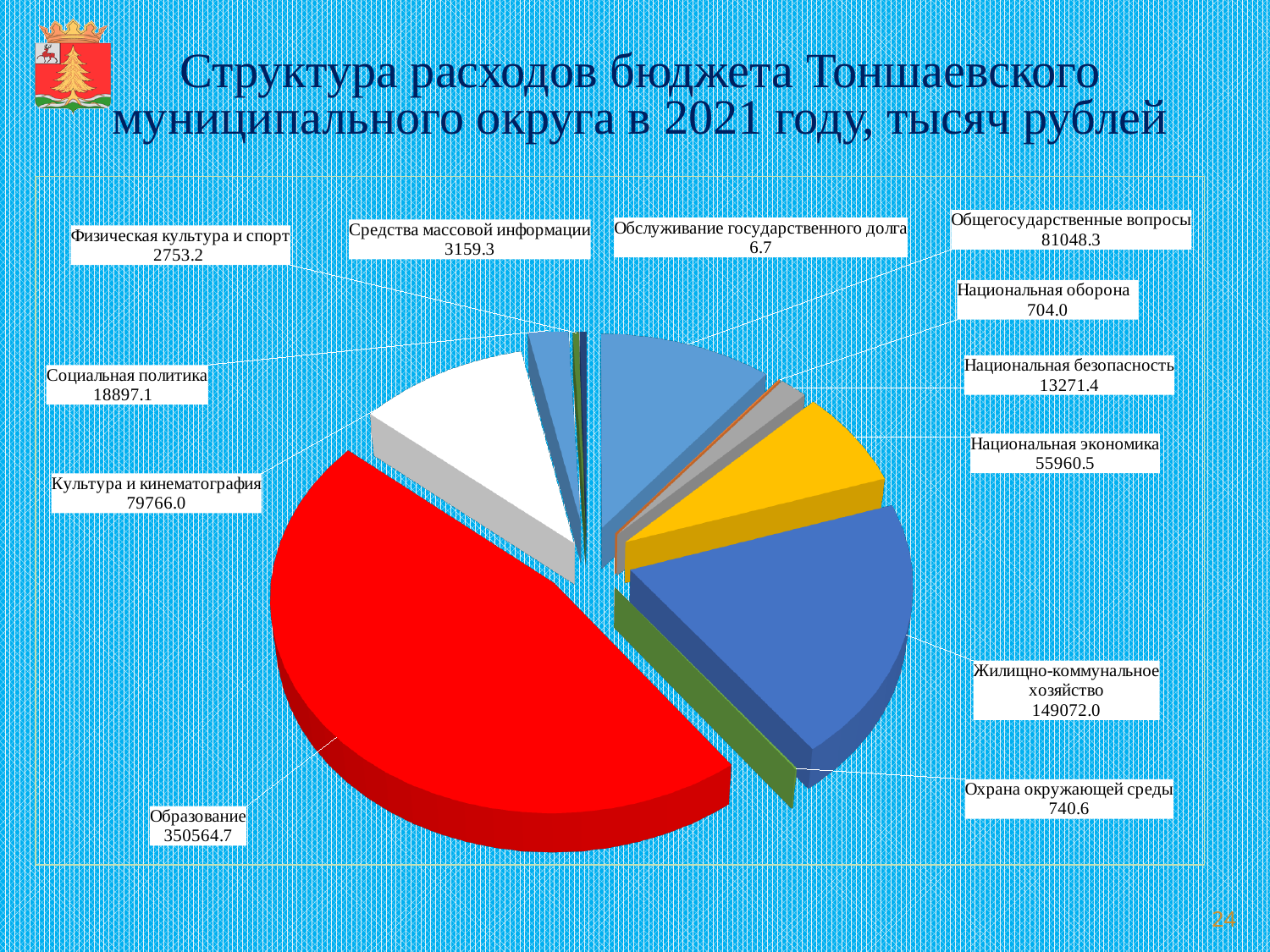
What is the value for Образование? 350564.7 In what units are the values in the chart expressed, according to the title? тысяч рублей What is the value for Социальная политика? 18897.1 Which category has the largest value in the pie chart? Образование How many categories (slices) does the pie chart show? 12 What is the value for Национальная оборона? 704.0 What is the difference between Жилищно-коммунальное хозяйство and Общегосударственные вопросы? 68023.7 What is the difference between Национальная экономика and Социальная политика? 37063.4 What kind of chart is shown on the slide? Pie chart What is the value for Жилищно-коммунальное хозяйство? 149072.0 Which is larger: Общегосударственные вопросы or Культура и кинематография? Общегосударственные вопросы Which category has the smallest value in the pie chart? Обслуживание государственного долга